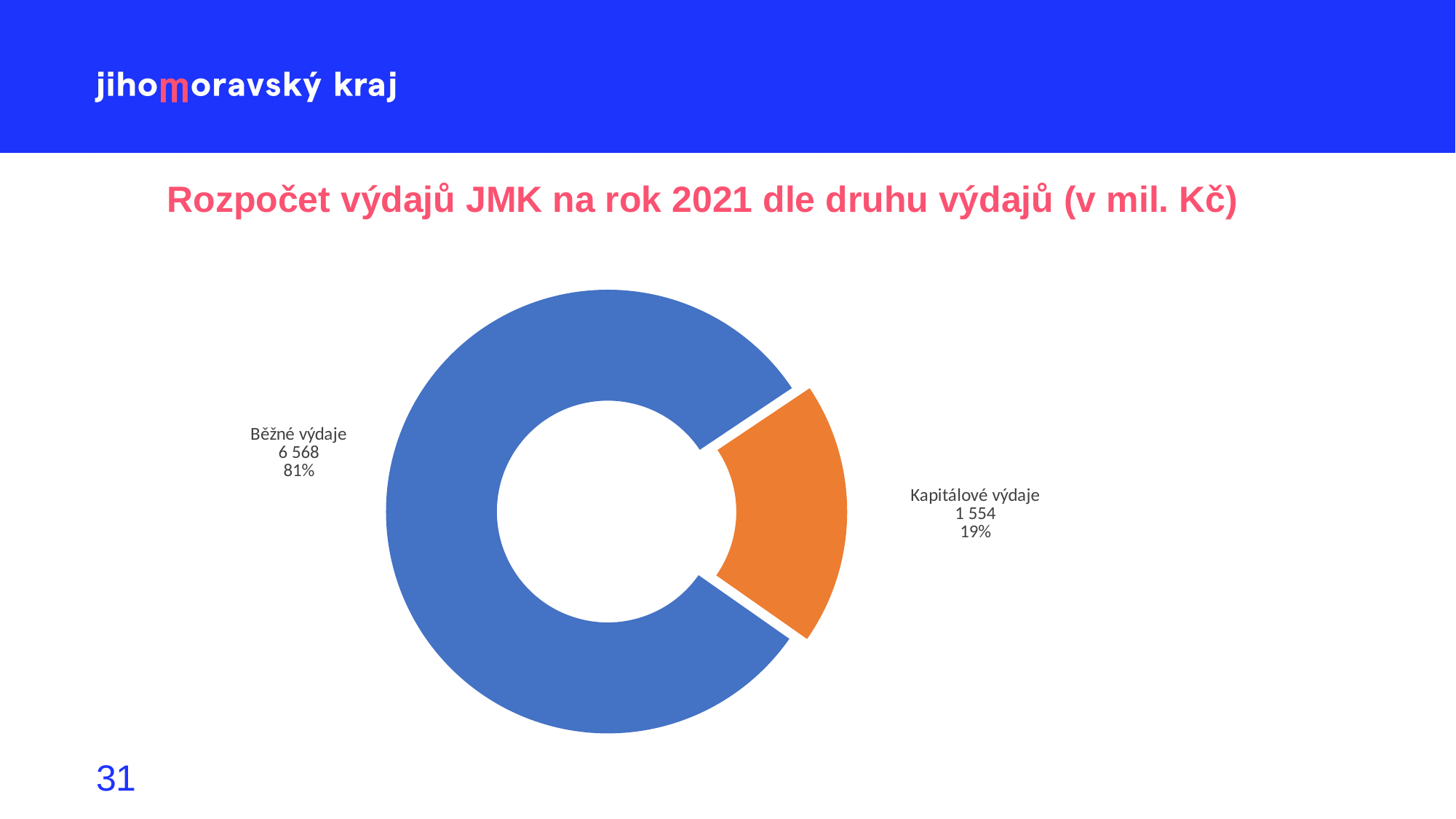
What is the total of the two categories shown? 8 122 What is the difference between Běžné výdaje and Kapitálové výdaje? 5 014 How many categories are shown in the chart? 2 Which category has the largest value? Běžné výdaje What kind of chart is shown on the slide? Pie chart (doughnut) What is the value for Kapitálové výdaje? 1 554 Which category has the smallest value? Kapitálové výdaje What is the title of the chart? Rozpočet výdajů JMK na rok 2021 dle druhu výdajů (v mil. Kč) What is the value for Běžné výdaje? 6 568 Which is larger, Běžné výdaje or Kapitálové výdaje? Běžné výdaje What share of the pie does Běžné výdaje represent? 81% What share of the pie does Kapitálové výdaje represent? 19%